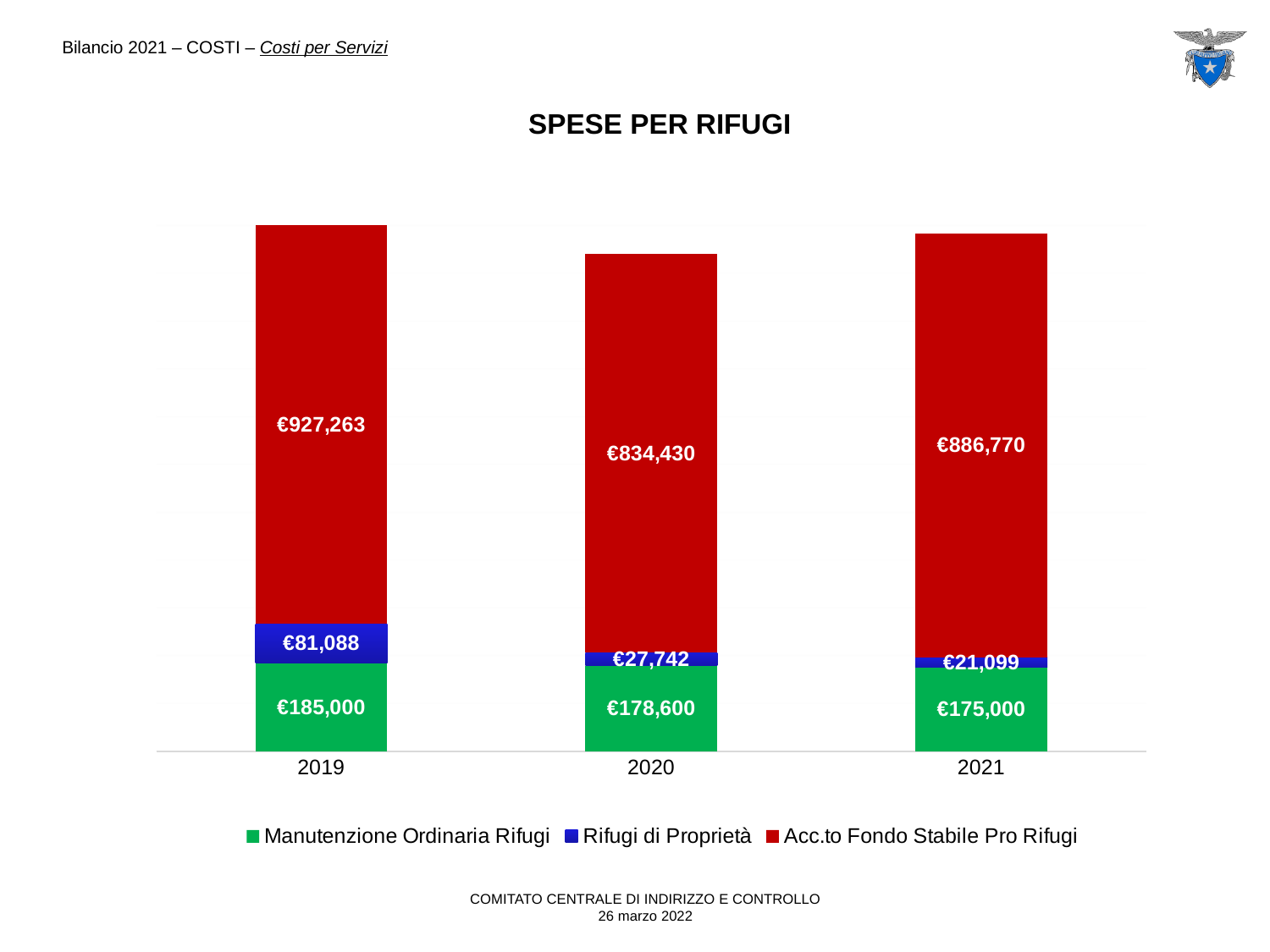
What is the total of the stacked bar for 2021? €1,082,869 In which year is Rifugi di Proprietà the highest? 2019 What is the value of Acc.to Fondo Stabile Pro Rifugi in 2019? €927,263 What is the value of Rifugi di Proprietà in 2020? €27,742 How many series does the legend list? 3 What is the value of Manutenzione Ordinaria Rifugi in 2021? €175,000 Which is larger: Manutenzione Ordinaria Rifugi in 2019 or in 2020? 2019 What is the difference between Rifugi di Proprietà in 2019 and in 2020? €53,346 How many years are shown on the x axis? 3 What is the difference between Acc.to Fondo Stabile Pro Rifugi in 2019 and in 2021? €40,493 What is the total of the stacked bar for 2020? €1,040,772 In which year is Acc.to Fondo Stabile Pro Rifugi the lowest? 2020